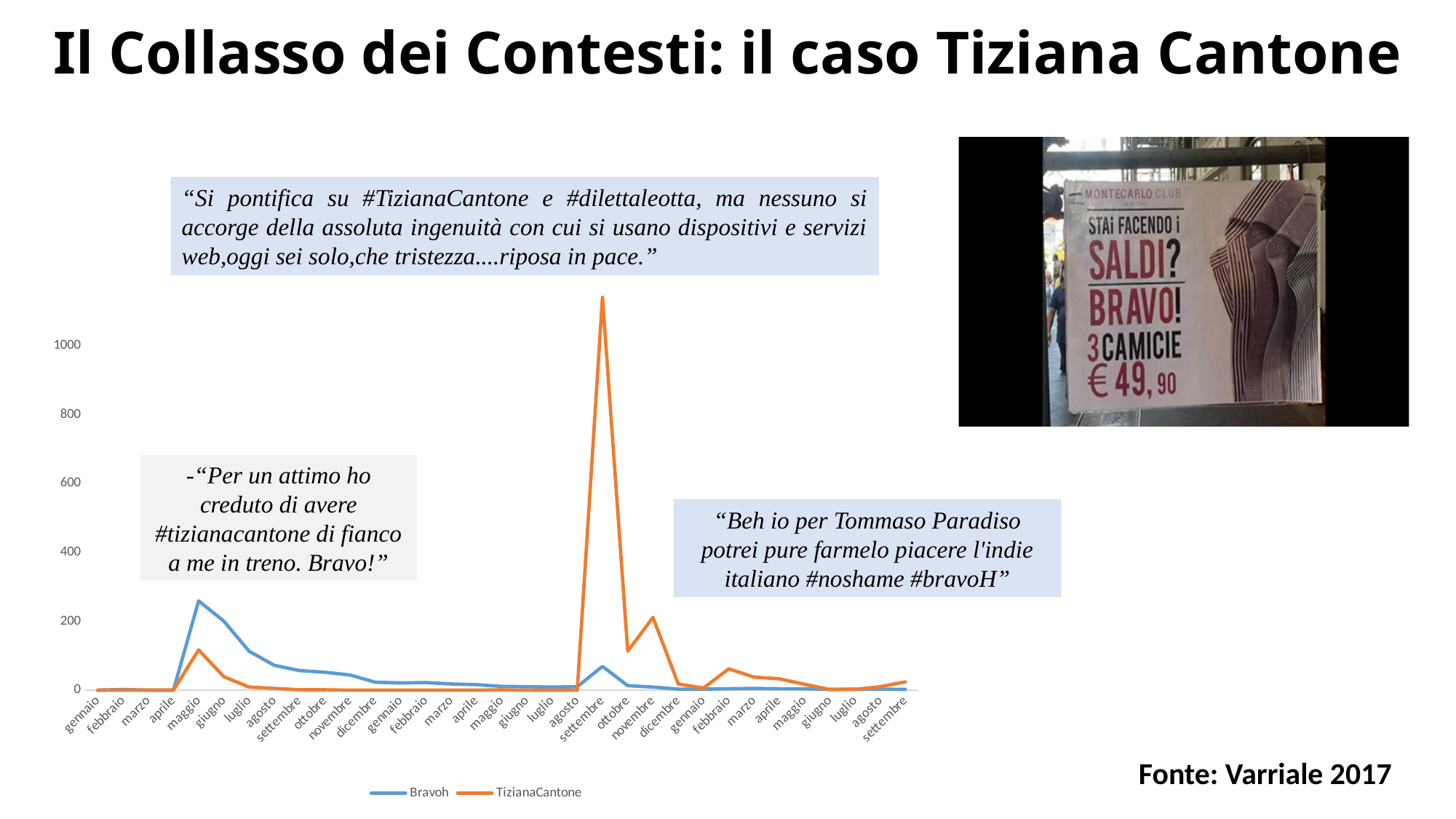
Is the peak value of the Bravoh line greater or less than 200? greater Is the peak value of the Bravoh line greater or less than 400? less In which month does the TizianaCantone line reach its highest value? settembre Which colour is used for the TizianaCantone line? orange At the first maggio on the x axis, which series has the higher value, Bravoh or TizianaCantone? Bravoh What are the names of the two series in the chart legend? Bravoh and TizianaCantone Is the peak value of the TizianaCantone line greater or less than 1000? greater What kind of chart is shown on the slide? line chart Which series reaches the higher overall peak, Bravoh or TizianaCantone? TizianaCantone How many series does the chart legend list? 2 How many monthly points are plotted along the x axis of the chart? 33 After its peak in settembre, does the TizianaCantone line rise or fall over the following months? fall